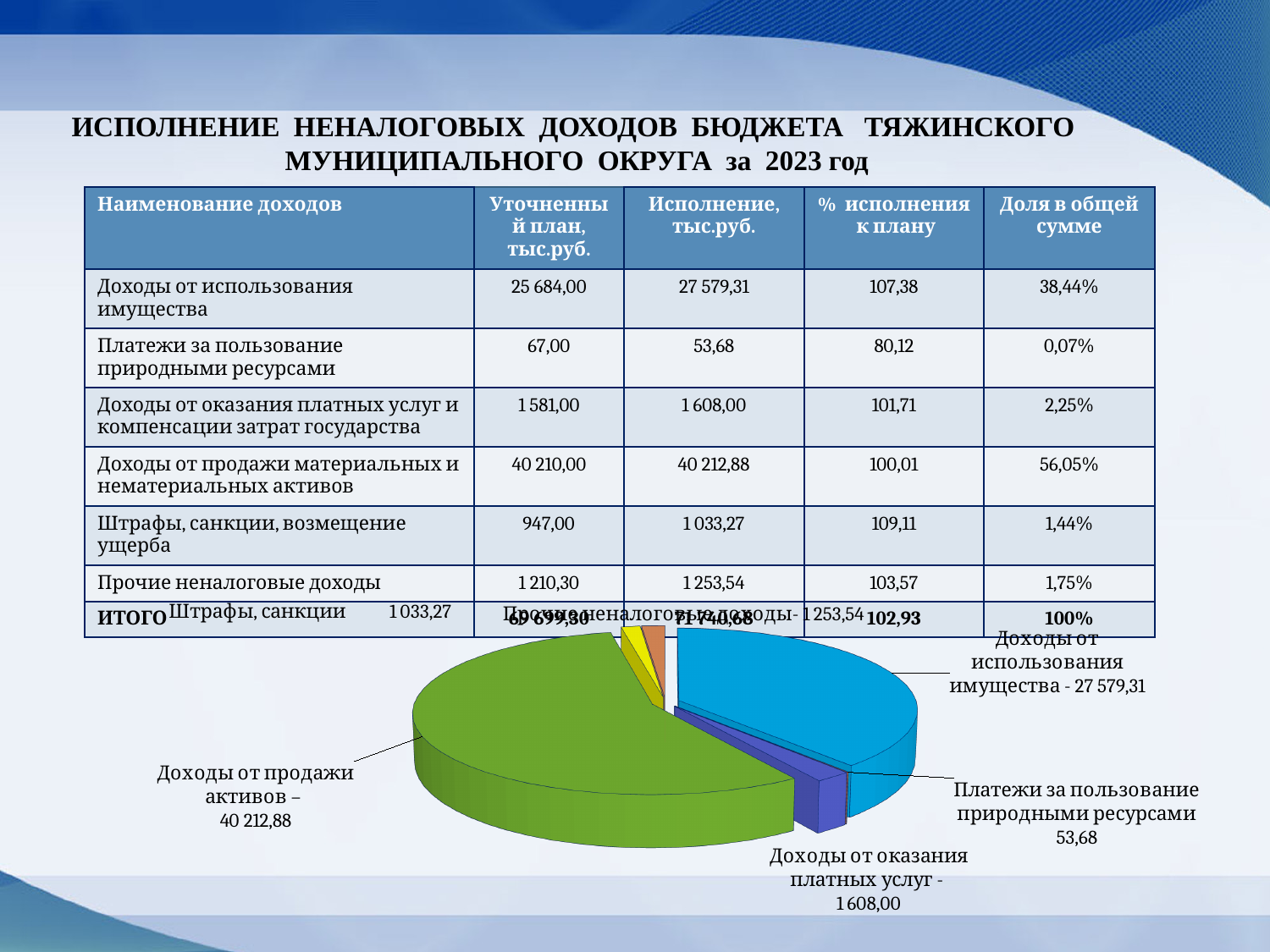
What kind of chart is shown on the slide? Pie chart What value is shown for Штрафы, санкции in the pie chart? 1 033,27 What value is shown for Доходы от продажи активов in the pie chart? 40 212,88 What is the difference between the values for Доходы от продажи активов and Доходы от использования имущества in the pie chart? 12 633,57 Which category has the largest slice in the pie chart? Доходы от продажи активов What value is shown for Доходы от использования имущества in the pie chart? 27 579,31 What value is shown for Платежи за пользование природными ресурсами in the pie chart? 53,68 Which category has the smallest slice in the pie chart? Платежи за пользование природными ресурсами How many slices does the pie chart have? 6 What value is shown for Доходы от оказания платных услуг in the pie chart? 1 608,00 Which is larger in the pie chart: Доходы от оказания платных услуг or Прочие неналоговые доходы? Доходы от оказания платных услуг What colour is the largest slice of the pie chart? Green